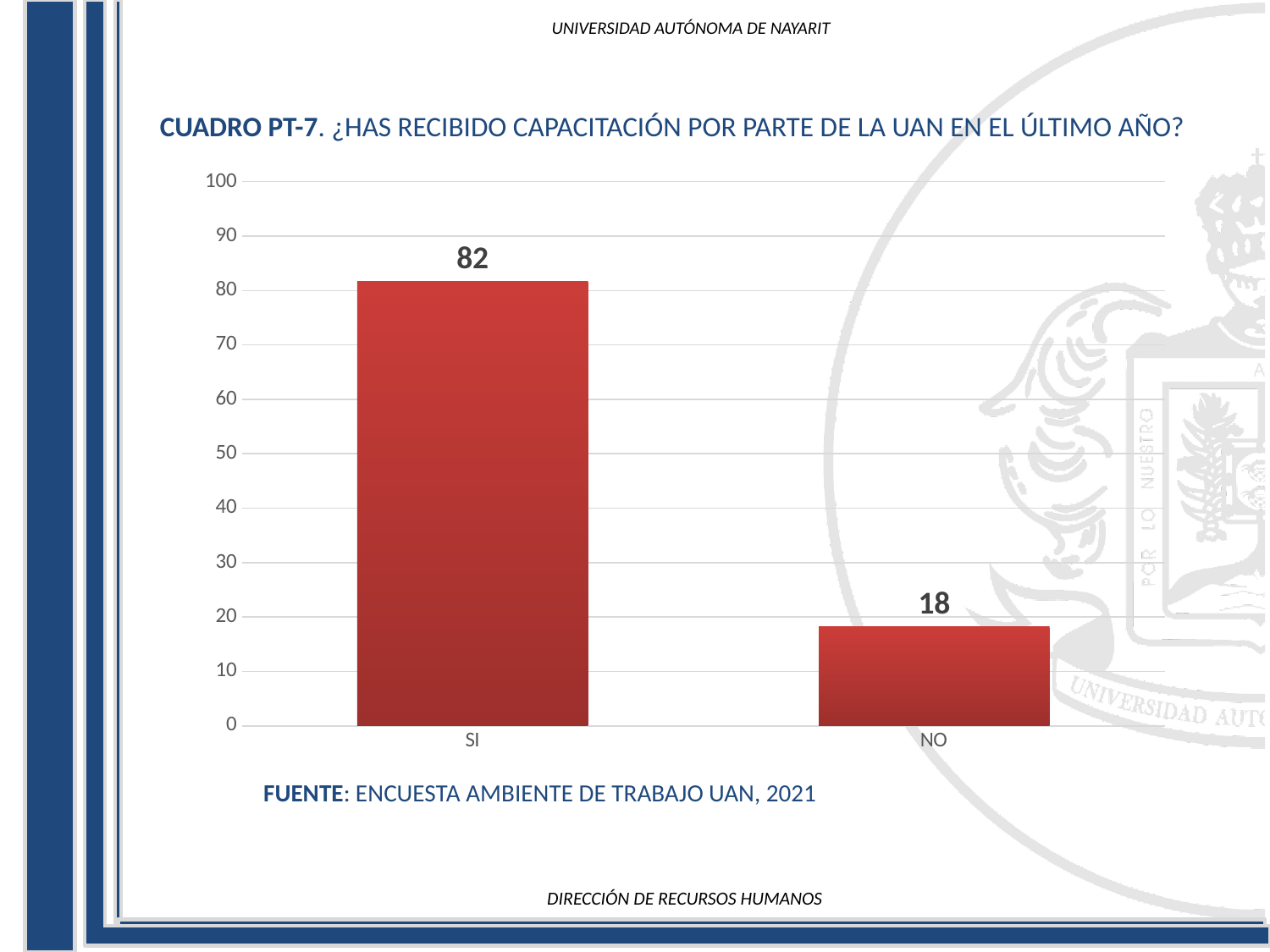
What is the value for NO? 18 Which category has the highest value? SI What is the total of the two bar values? 100 Which is larger, the value for SI or the value for NO? SI Is the value for NO greater or less than 20? less Is the value for SI greater or less than 80? greater What is the difference between the values for SI and NO? 64 What kind of chart is shown on the slide? bar chart How many categories are shown on the x axis? 2 Which category has the lowest value? NO What source is cited below the chart? ENCUESTA AMBIENTE DE TRABAJO UAN, 2021 What is the value for SI? 82